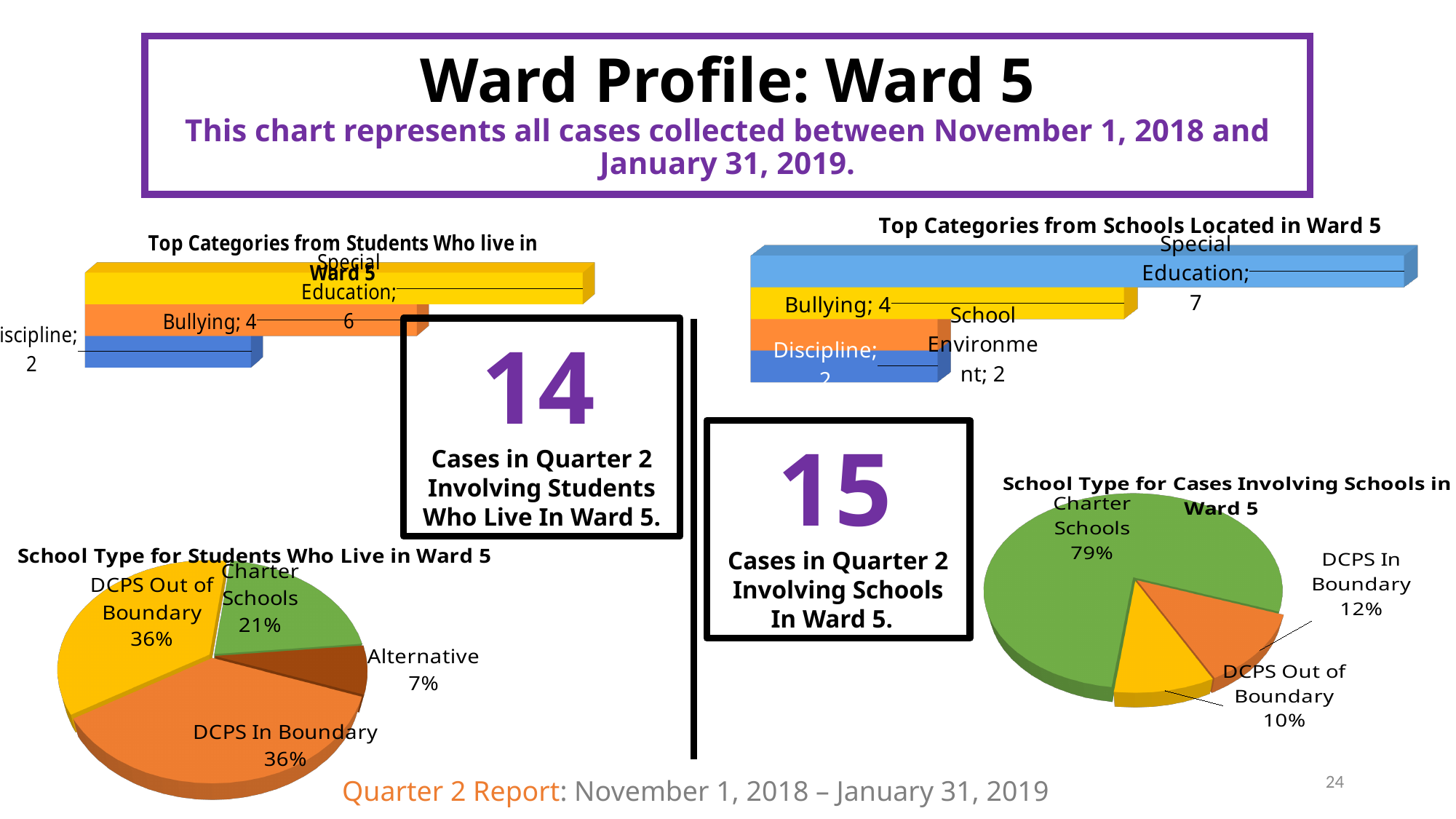
In the 'Top Categories from Schools Located in Ward 5' chart, what is the value for Special Education? 7 In the 'Top Categories from Students Who live in Ward 5' chart, what is the value for Special Education? 6 In the 'School Type for Students Who Live in Ward 5' pie chart, what share is Charter Schools? 21% In the 'School Type for Cases Involving Schools in Ward 5' pie chart, what share is Charter Schools? 79% In the 'Top Categories from Schools Located in Ward 5' chart, how many categories are shown? 4 What kind of chart is 'Top Categories from Schools Located in Ward 5'? Bar chart In the 'School Type for Cases Involving Schools in Ward 5' pie chart, which is larger: DCPS In Boundary or DCPS Out of Boundary? DCPS In Boundary In the 'Top Categories from Students Who live in Ward 5' chart, what is the value for Bullying? 4 In the 'Top Categories from Students Who live in Ward 5' chart, which category has the highest value? Special Education In the 'Top Categories from Schools Located in Ward 5' chart, what is the value for School Environment? 2 In the 'Top Categories from Schools Located in Ward 5' chart, what is the difference between Special Education and Bullying? 3 In the 'School Type for Students Who Live in Ward 5' pie chart, which school type has the smallest share? Alternative